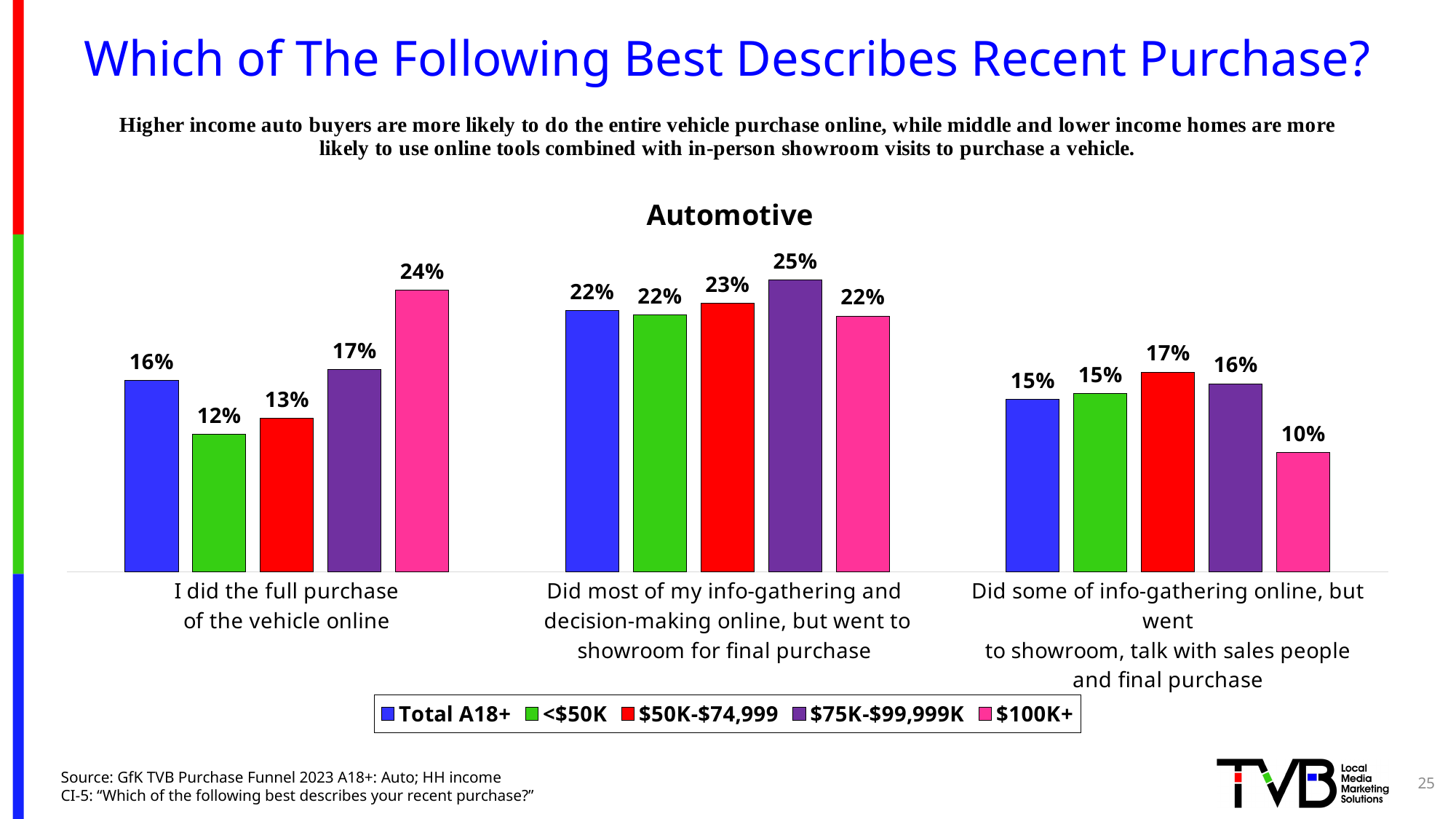
What is the value for <$50K in the 'Did some of info-gathering online, but went to showroom, talk with sales people and final purchase' category? 15% Which income group has the highest value in the 'Did most of my info-gathering and decision-making online, but went to showroom for final purchase' category? $75K-$99,999K What colour represents the $100K+ series in the chart? Pink In the 'Did some of info-gathering online, but went to showroom, talk with sales people and final purchase' category, which is larger: $50K-$74,999 or $100K+? $50K-$74,999 What is the value for Total A18+ in the 'Did most of my info-gathering and decision-making online, but went to showroom for final purchase' category? 22% What is the value for $100K+ in the 'I did the full purchase of the vehicle online' category? 24% Which income group has the lowest value in the 'I did the full purchase of the vehicle online' category? <$50K What kind of chart is shown on the slide? Bar chart How many series does the legend list? 5 What is the title of the chart? Automotive What is the difference between the $100K+ and <$50K values in the 'I did the full purchase of the vehicle online' category? 12% How many categories are shown on the x axis? 3